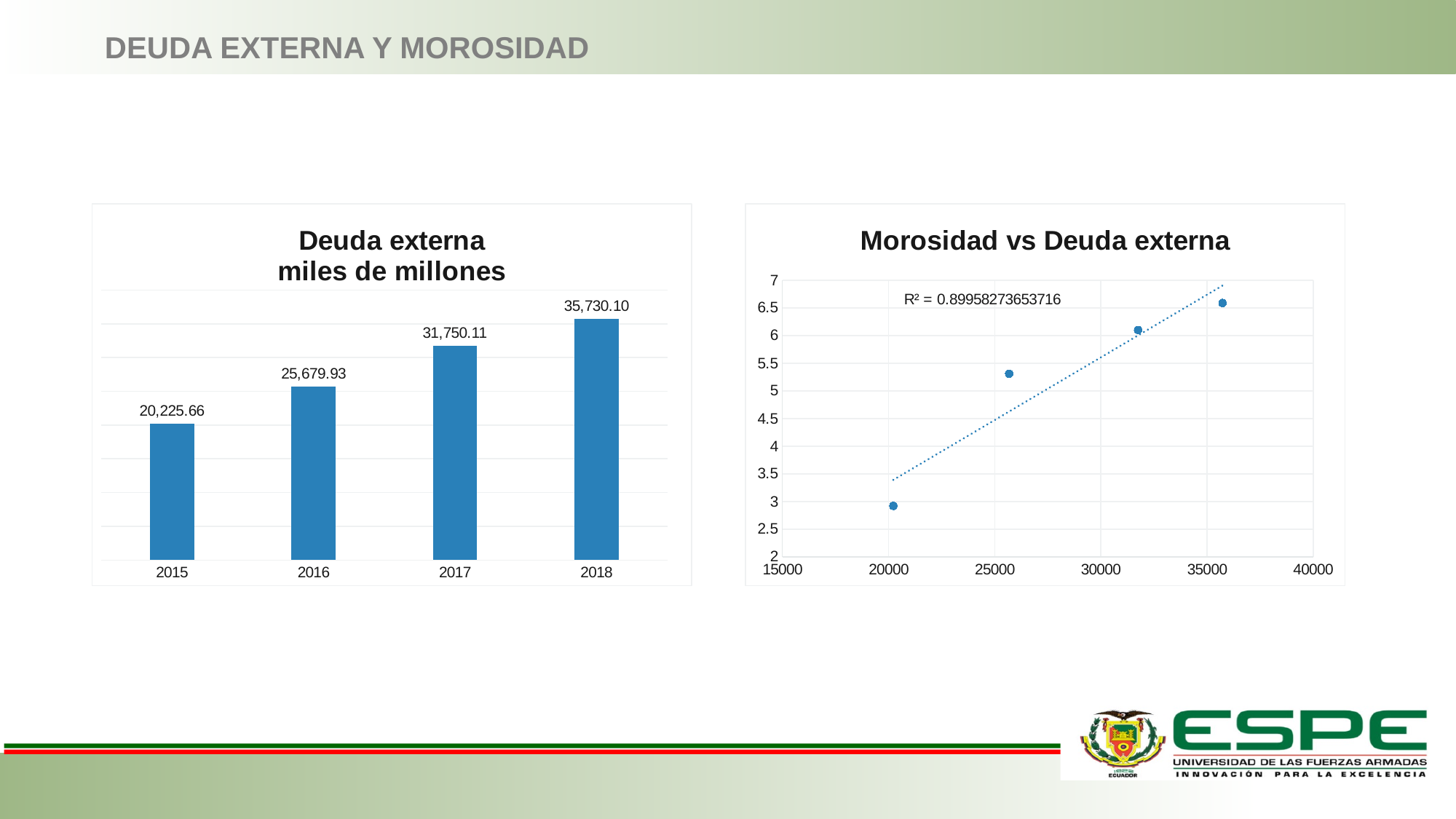
In the 'Deuda externa miles de millones' chart, which is larger, the value for 2016 or the value for 2017? 2017 In the 'Deuda externa miles de millones' chart, which year has the highest value? 2018 In the 'Deuda externa miles de millones' chart, do the values rise or fall from 2015 to 2018? rise In the 'Deuda externa miles de millones' chart, what is the value for 2015? 20,225.66 In the 'Deuda externa miles de millones' chart, what is the value for 2017? 31,750.11 What kind of chart is 'Morosidad vs Deuda externa'? scatter chart How many data points are plotted in the 'Morosidad vs Deuda externa' chart? 4 What R² value is shown on the 'Morosidad vs Deuda externa' chart? R² = 0.89958273653716 In the 'Deuda externa miles de millones' chart, which year has the lowest value? 2015 In the 'Deuda externa miles de millones' chart, what is the difference between the 2018 and 2017 values? 3,979.99 What kind of chart is 'Deuda externa miles de millones'? bar chart How many bars are in the 'Deuda externa miles de millones' chart? 4